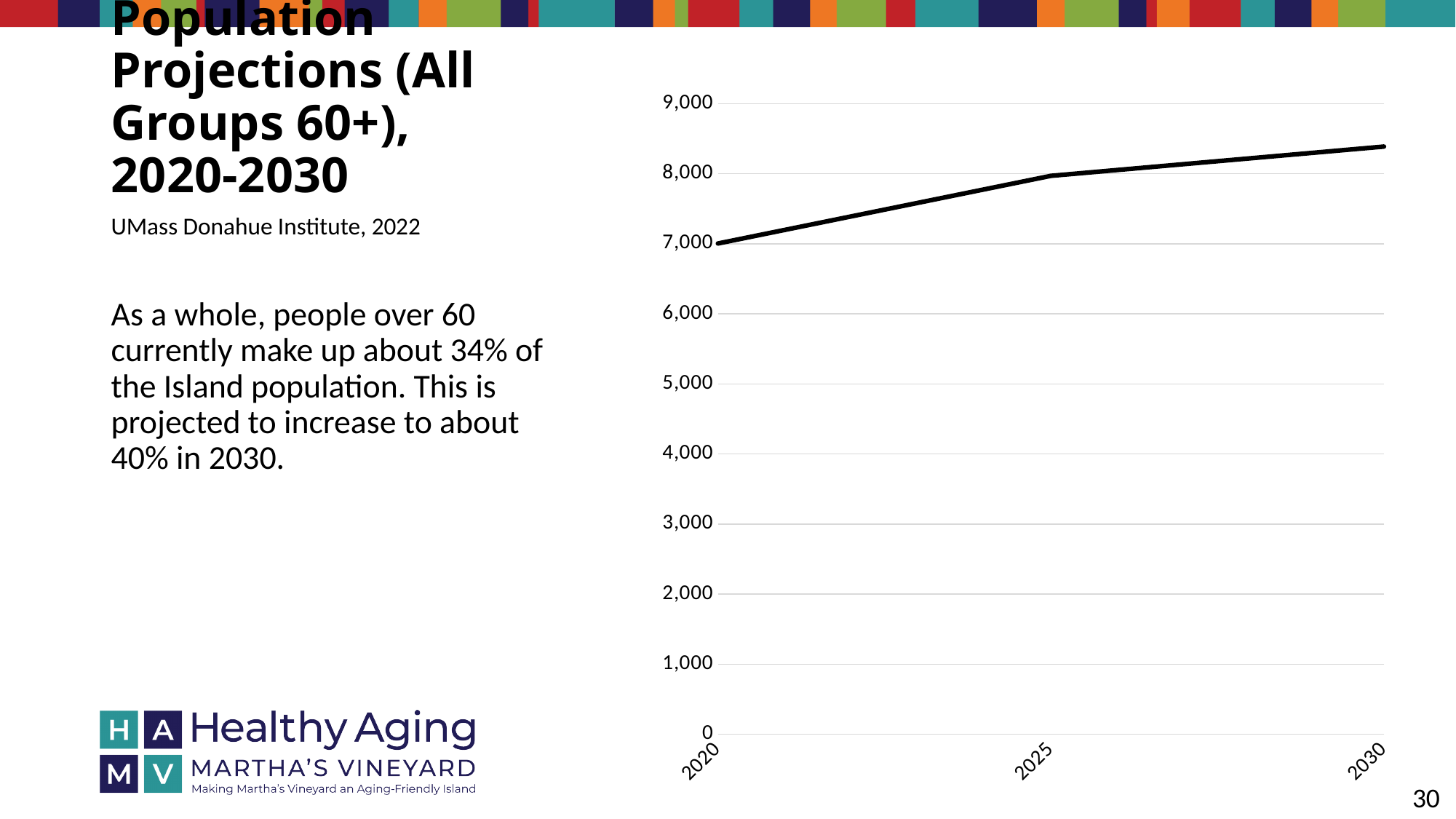
What kind of chart is shown on the slide? line chart Do the values in the chart rise or fall from 2020 to 2030? rise What is the title of the chart on the slide? Population Projections (All Groups 60+), 2020-2030 How many years are marked on the x axis of the chart? 3 Is the value for 2020 greater or less than 8,000? less Which year has the highest value in the chart? 2030 Is the value for 2030 greater or less than 9,000? less What source is cited for the chart data? UMass Donahue Institute, 2022 Which year has the larger value, 2020 or 2030? 2030 Which year has the lowest value in the chart? 2020 Is the value for 2030 greater or less than 8,000? greater